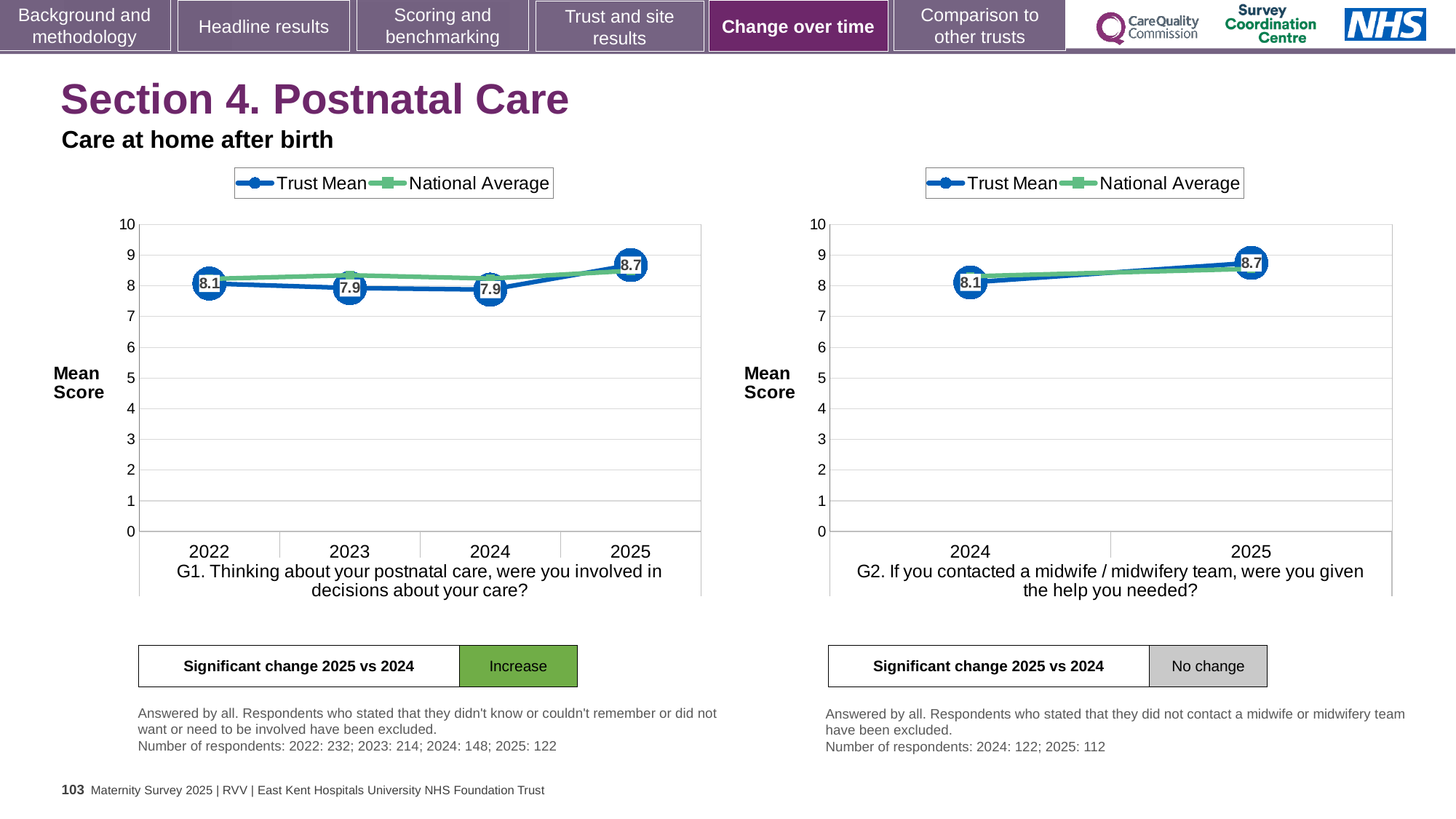
How many years are plotted on the x axis of the G1 chart (left)? 4 In the G1 chart (left), what is the Trust Mean score for 2025? 8.7 In the G2 chart (right), what is the Trust Mean score for 2025? 8.7 In the G1 chart (left), what is the difference between the Trust Mean score in 2025 and in 2024? 0.8 In the G1 chart (left), what is the Trust Mean score for 2022? 8.1 How many series does the legend of the G2 chart (right) list? 2 What type of chart is the G2 chart (right)? Line chart In the G2 chart (right), what is the difference between the Trust Mean score in 2025 and in 2024? 0.6 In the G2 chart (right), what is the Trust Mean score for 2024? 8.1 In the G1 chart (left), which year has the highest Trust Mean score? 2025 In the G1 chart (left), is the Trust Mean score for 2022 larger than the Trust Mean score for 2023? Yes In the G1 chart (left), what is the Trust Mean score for 2023? 7.9